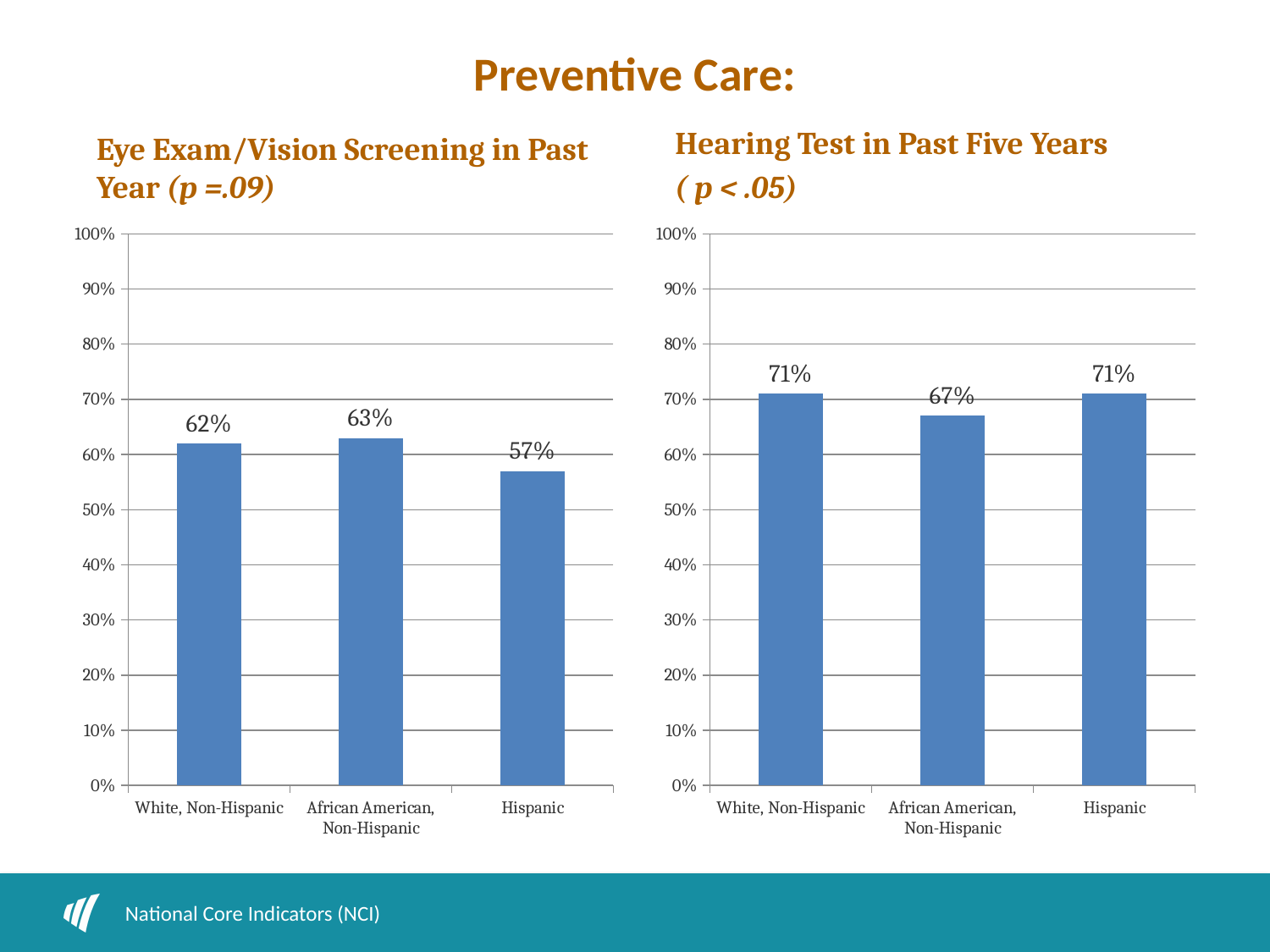
In the Hearing Test in Past Five Years chart, what is the difference between the White, Non-Hispanic value and the African American, Non-Hispanic value? 4% In the Eye Exam/Vision Screening in Past Year chart, what is the value for Hispanic? 57% In the Eye Exam/Vision Screening in Past Year chart, is the value for Hispanic greater or less than 70%? less In the Hearing Test in Past Five Years chart, is the value for White, Non-Hispanic greater or less than 60%? greater What kind of chart is the Eye Exam/Vision Screening in Past Year chart? bar chart In the Eye Exam/Vision Screening in Past Year chart, what is the difference between the African American, Non-Hispanic value and the Hispanic value? 6% In the Eye Exam/Vision Screening in Past Year chart, which category has the lowest value? Hispanic In the Hearing Test in Past Five Years chart, which category has the lowest value? African American, Non-Hispanic In the Hearing Test in Past Five Years chart, what is the value for African American, Non-Hispanic? 67% In the Eye Exam/Vision Screening in Past Year chart, what is the value for White, Non-Hispanic? 62% How many categories are shown in the Hearing Test in Past Five Years chart? 3 What is the main title at the top of the slide? Preventive Care: